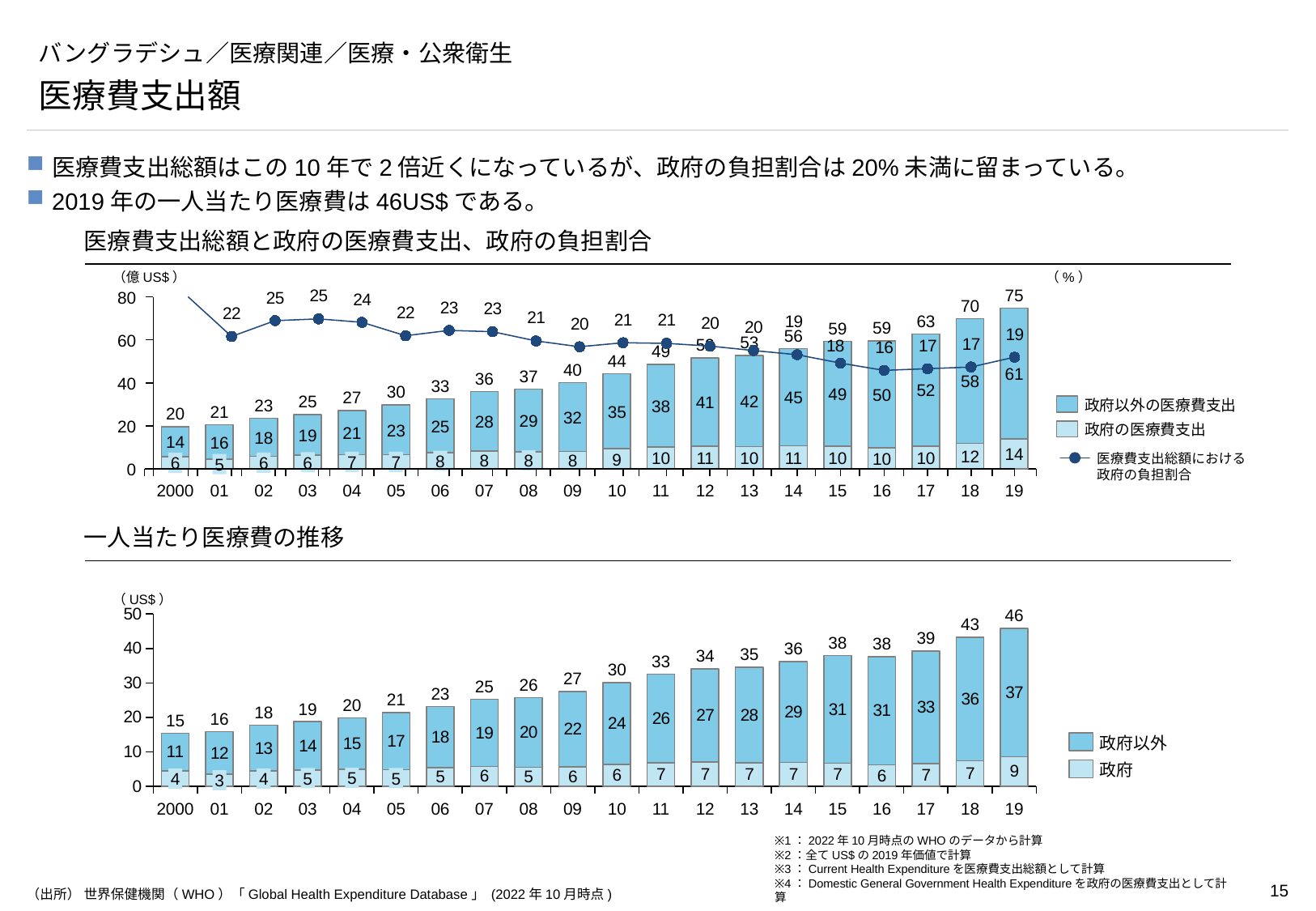
In the top chart, what is the government share (政府の負担割合, %) for 2016? 16 What kind of chart is the bottom chart (一人当たり医療費の推移)? stacked bar chart In the bottom chart (一人当たり医療費の推移), what is the per-capita health expenditure (US$) for 2019? 46 In the bottom chart, which year has the lowest total per-capita health expenditure? 2000 In the top chart, how many series does the legend list? 3 In the bottom chart, what is the 政府 value for 2001? 3 In the top chart, what is the value of 政府の医療費支出 for 2018? 12 In the top chart, does the government share line generally rise or fall from 2001 to 2019? fall In the top chart, what is the difference between 政府以外の医療費支出 in 2019 and in 2000? 47 In the bottom chart, how many years are shown on the x axis? 20 In the top chart, which year has the highest total health expenditure? 19 In the top chart (医療費支出総額と政府の医療費支出、政府の負担割合), what is the total health expenditure (億 US$) for 2019? 75